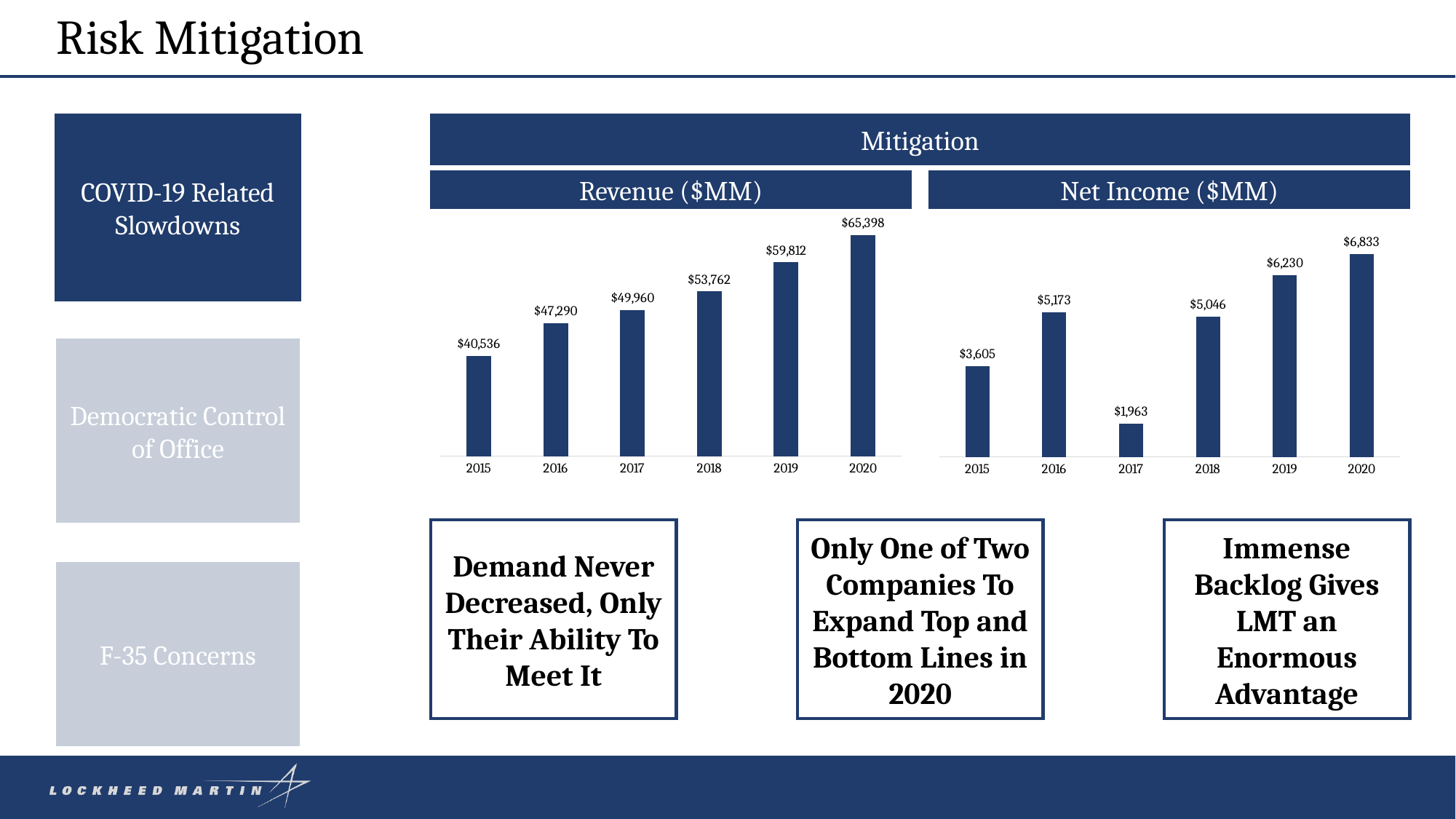
In the Net Income ($MM) chart, what is the difference between the 2020 and 2019 values? $603 In the Revenue ($MM) chart, which year has the highest value? 2020 How many years are shown in the Revenue ($MM) chart? 6 What is the title of the chart on the left? Revenue ($MM) In the Net Income ($MM) chart, which year has the lowest value? 2017 What kind of chart is the Net Income ($MM) chart? Bar chart In the Net Income ($MM) chart, which is larger, the value for 2016 or the value for 2018? 2016 In the Revenue ($MM) chart, what is the value for 2018? $53,762 In the Net Income ($MM) chart, what is the value for 2015? $3,605 In the Net Income ($MM) chart, what is the value for 2017? $1,963 In the Revenue ($MM) chart, do the values rise or fall from 2015 to 2020? Rise In the Revenue ($MM) chart, what is the difference between the 2020 and 2015 values? $24,862